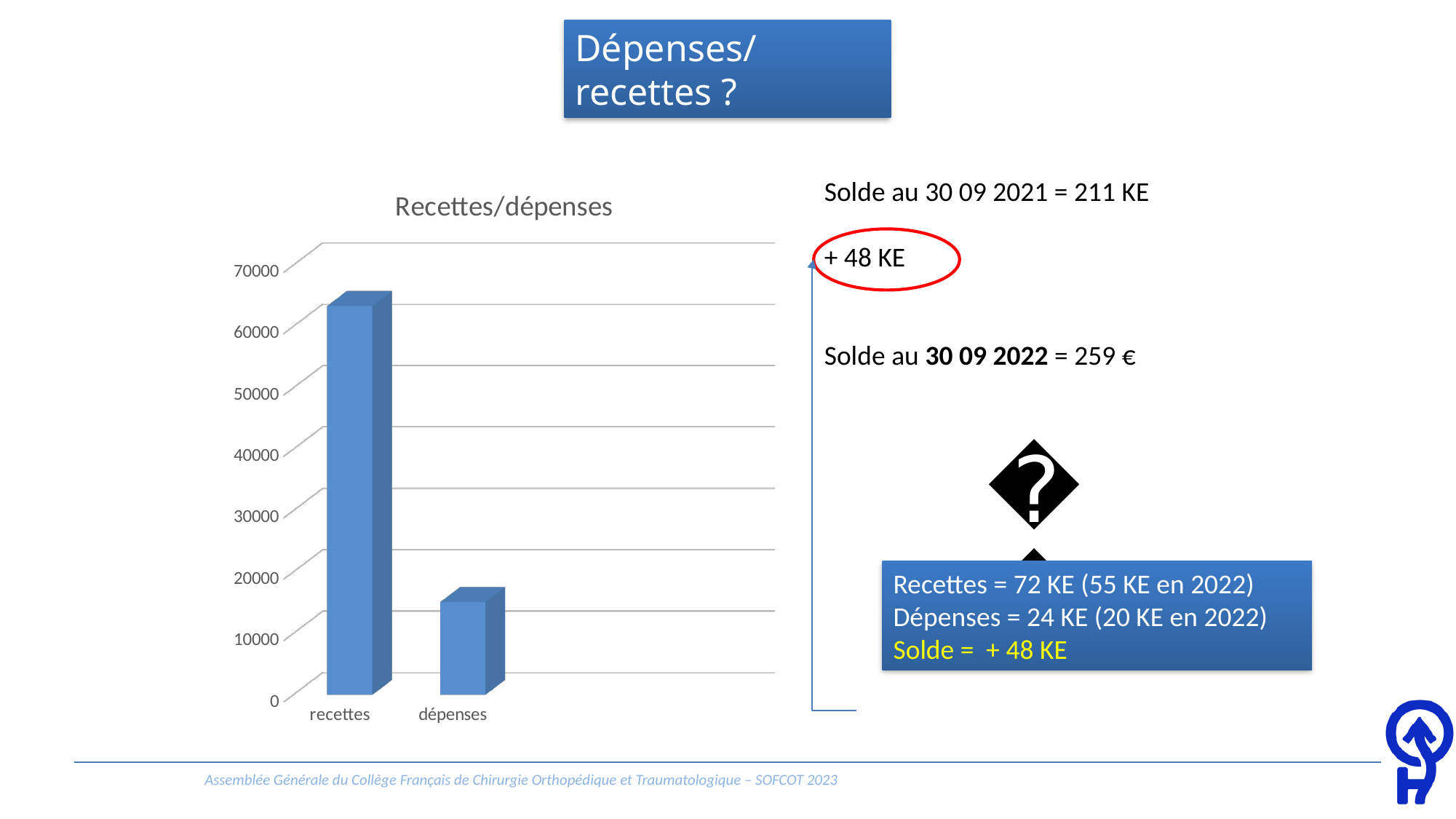
Which category has the lowest value in the chart? dépenses Is the value for dépenses greater or less than 10000? greater Is the value for recettes greater or less than 50000? greater Which is larger in the chart, recettes or dépenses? recettes What is the title of the chart? Recettes/dépenses What kind of chart is shown on the slide? bar chart Is the value for recettes greater or less than 70000? less Do the values rise or fall from recettes to dépenses along the x axis? fall Which category has the highest value in the chart? recettes What is the highest value shown on the vertical axis of the chart? 70000 How many categories are plotted in the chart? 2